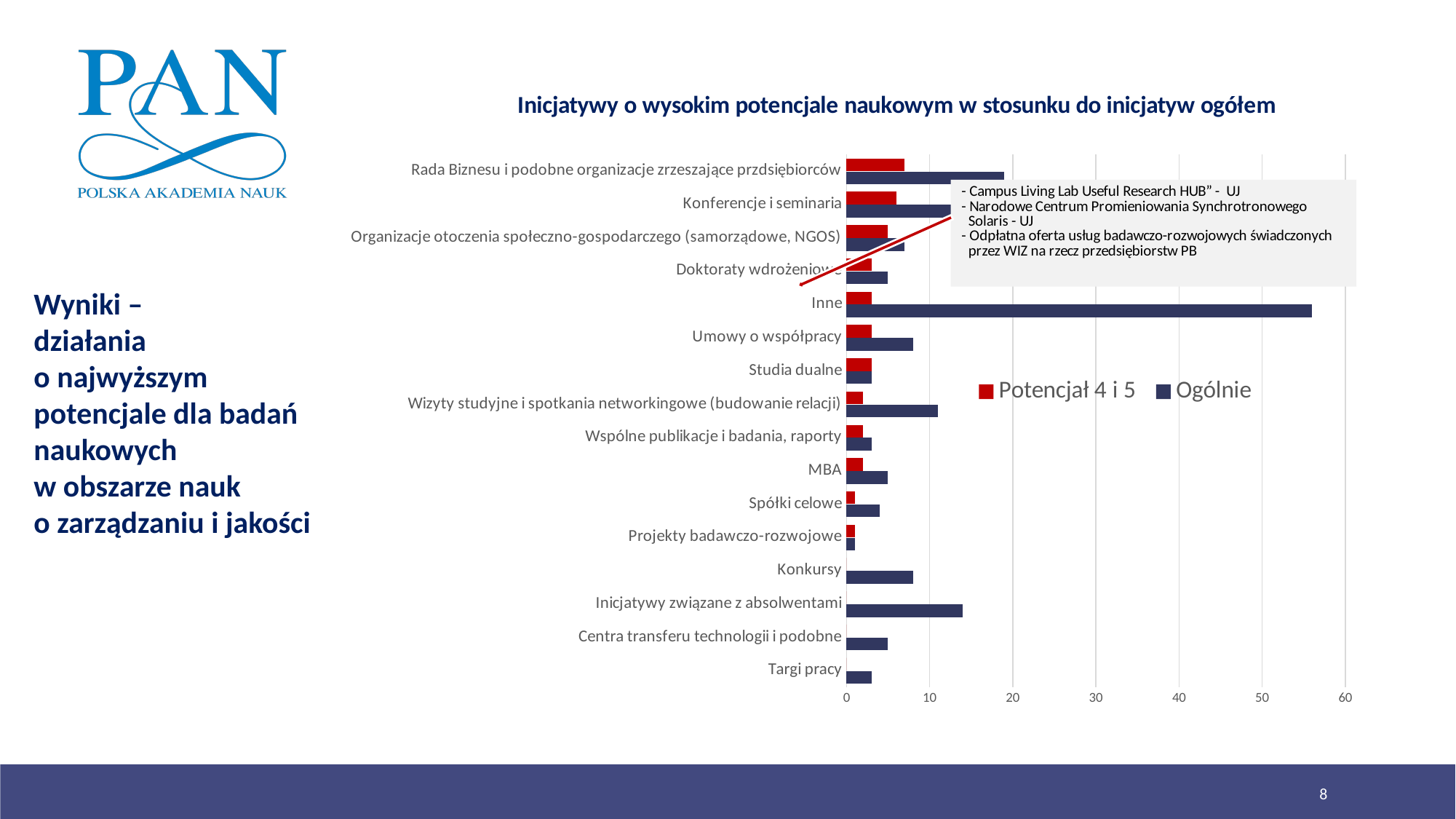
What kind of chart is shown on the slide? bar chart How many series does the chart legend list? 2 How many categories are shown on the chart's vertical axis? 16 Which category has the highest value for the Ogólnie series? Inne For the Ogólnie series, which is larger: Konkursy or Targi pracy? Konkursy Is the Ogólnie value for Targi pracy greater or less than 10? less What is the title of the chart? Inicjatywy o wysokim potencjale naukowym w stosunku do inicjatyw ogółem For the Ogólnie series, which is larger: Inne or Rada Biznesu i podobne organizacje zrzeszające przdsiębiorców? Inne Is the Ogólnie value for Inne greater or less than 50? greater Is the Ogólnie value for Inicjatywy związane z absolwentami greater or less than 10? greater Which category has the highest value for the Potencjał 4 i 5 series? Rada Biznesu i podobne organizacje zrzeszające przdsiębiorców Which series is shown in red in the chart? Potencjał 4 i 5